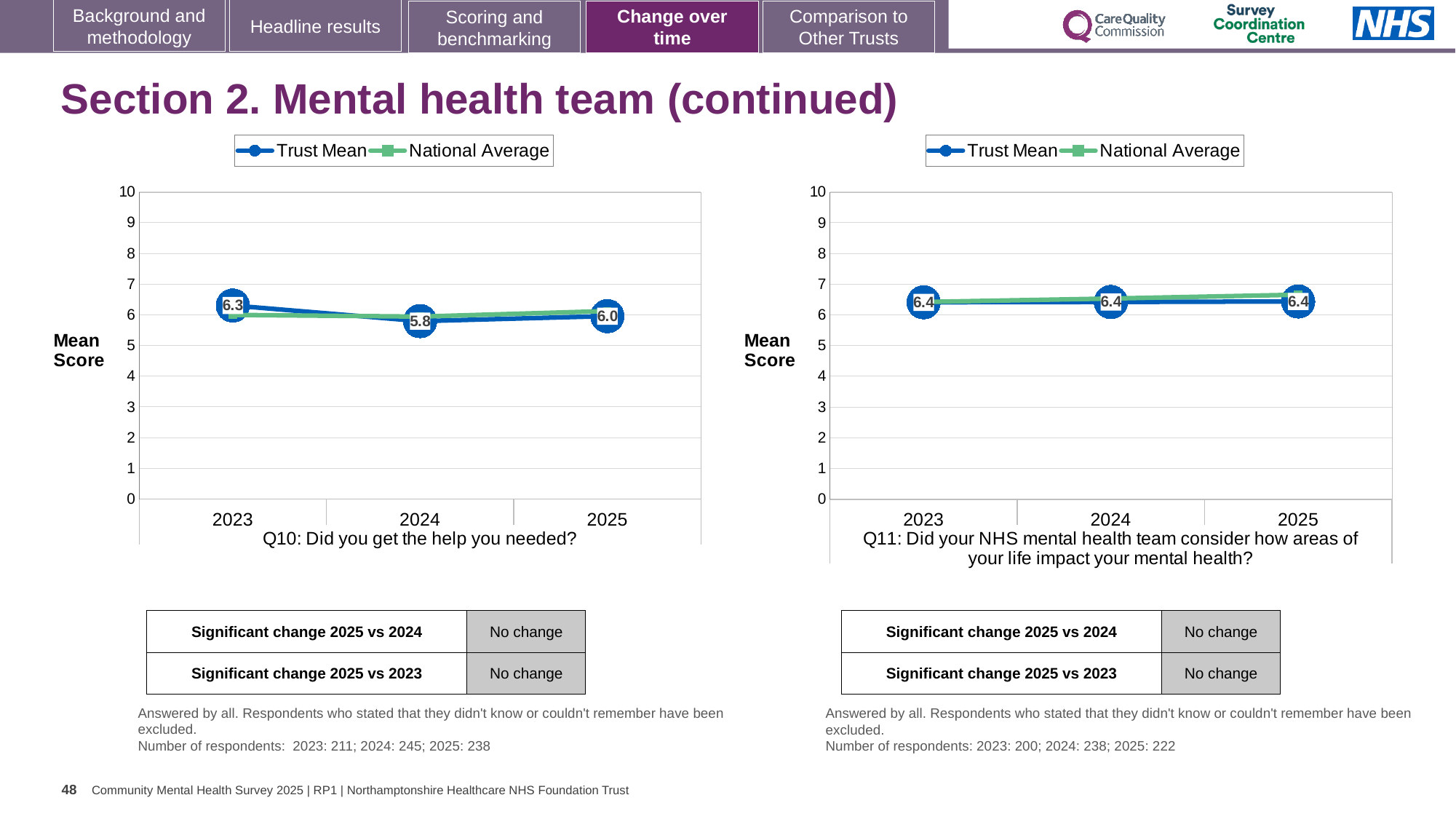
In the Q10 chart on the left, what is the difference between the Trust Mean for 2023 and 2024? 0.5 In the Q10 chart on the left, what is the Trust Mean for 2023? 6.3 In the Q10 chart on the left, what is the Trust Mean for 2024? 5.8 In the Q10 chart on the left, what is the Trust Mean for 2025? 6.0 In the Q10 chart on the left, which year has the highest Trust Mean? 2023 In the Q10 chart on the left, which year has the lowest Trust Mean? 2024 How many series does the legend of the Q10 chart on the left list? 2 What type of chart is the Q11 chart on the right? Line chart How many years are plotted on the x axis of the Q11 chart on the right? 3 In the Q10 chart on the left, is the Trust Mean higher in 2023 or in 2025? 2023 In the Q11 chart on the right, is the National Average for 2025 greater or less than 5? greater In the Q11 chart on the right, what is the Trust Mean for 2025? 6.4